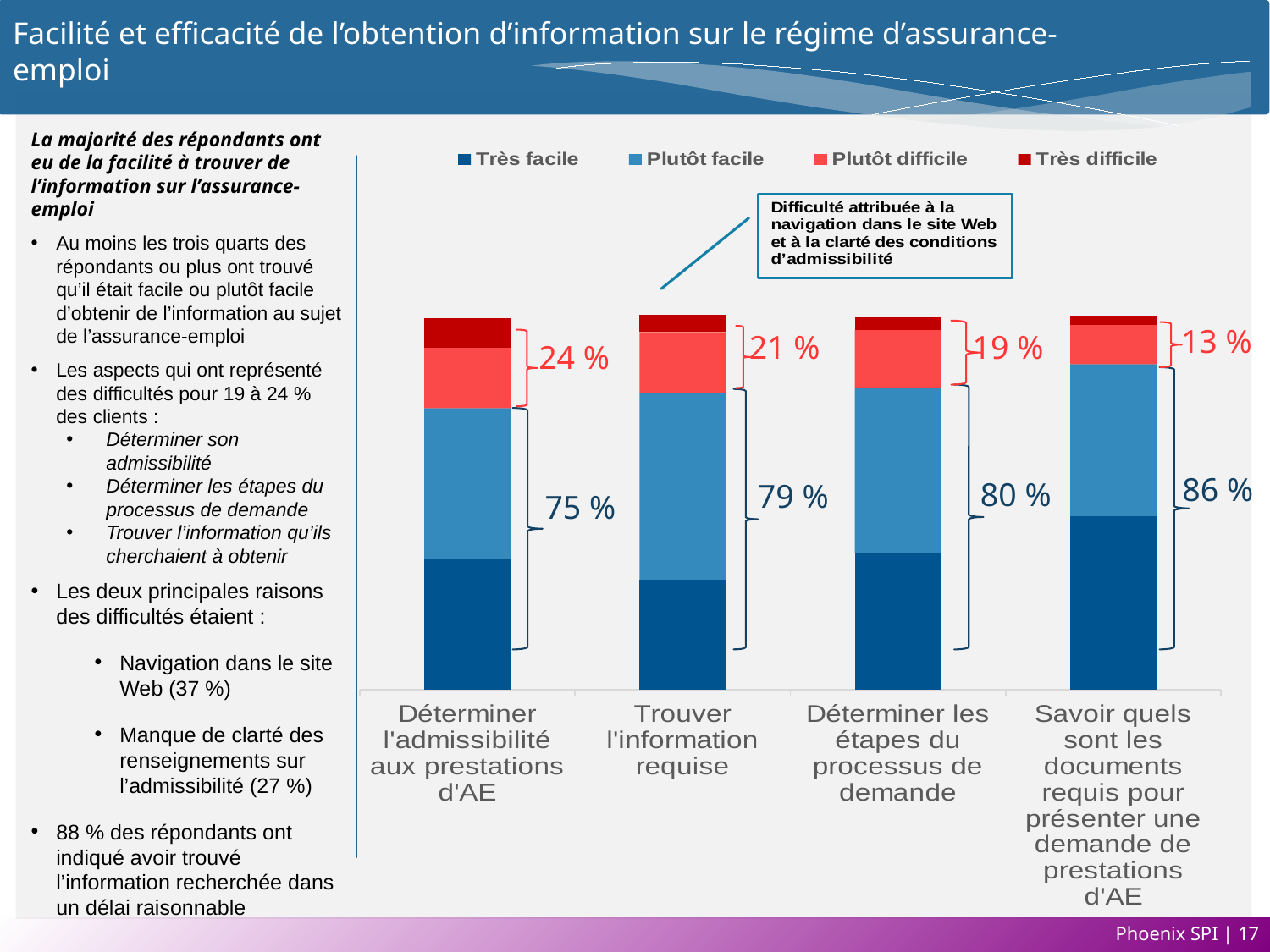
Which category has the highest combined difficult percentage? Déterminer l'admissibilité aux prestations d'AE How many categories are shown on the x axis of the chart? 4 What type of chart is shown on the slide? Stacked bar chart What combined difficult percentage is labelled for "Déterminer les étapes du processus de demande"? 19 % Which category has the highest combined easy percentage? Savoir quels sont les documents requis pour présenter une demande de prestations d'AE How many series does the chart legend list? 4 What is the difference between the combined easy percentages for "Savoir quels sont les documents requis..." (86 %) and "Déterminer l'admissibilité aux prestations d'AE" (75 %)? 11 % Which has a larger combined difficult percentage: "Trouver l'information requise" or "Déterminer les étapes du processus de demande"? Trouver l'information requise What combined easy percentage is labelled for "Savoir quels sont les documents requis pour présenter une demande de prestations d'AE"? 86 % What percentage of respondents found it difficult (plutôt difficile or très difficile) to "Trouver l'information requise"? 21 % Which series is shown in dark red in the chart legend? Très difficile What percentage of respondents found it easy (très facile or plutôt facile) to "Déterminer l'admissibilité aux prestations d'AE"? 75 %